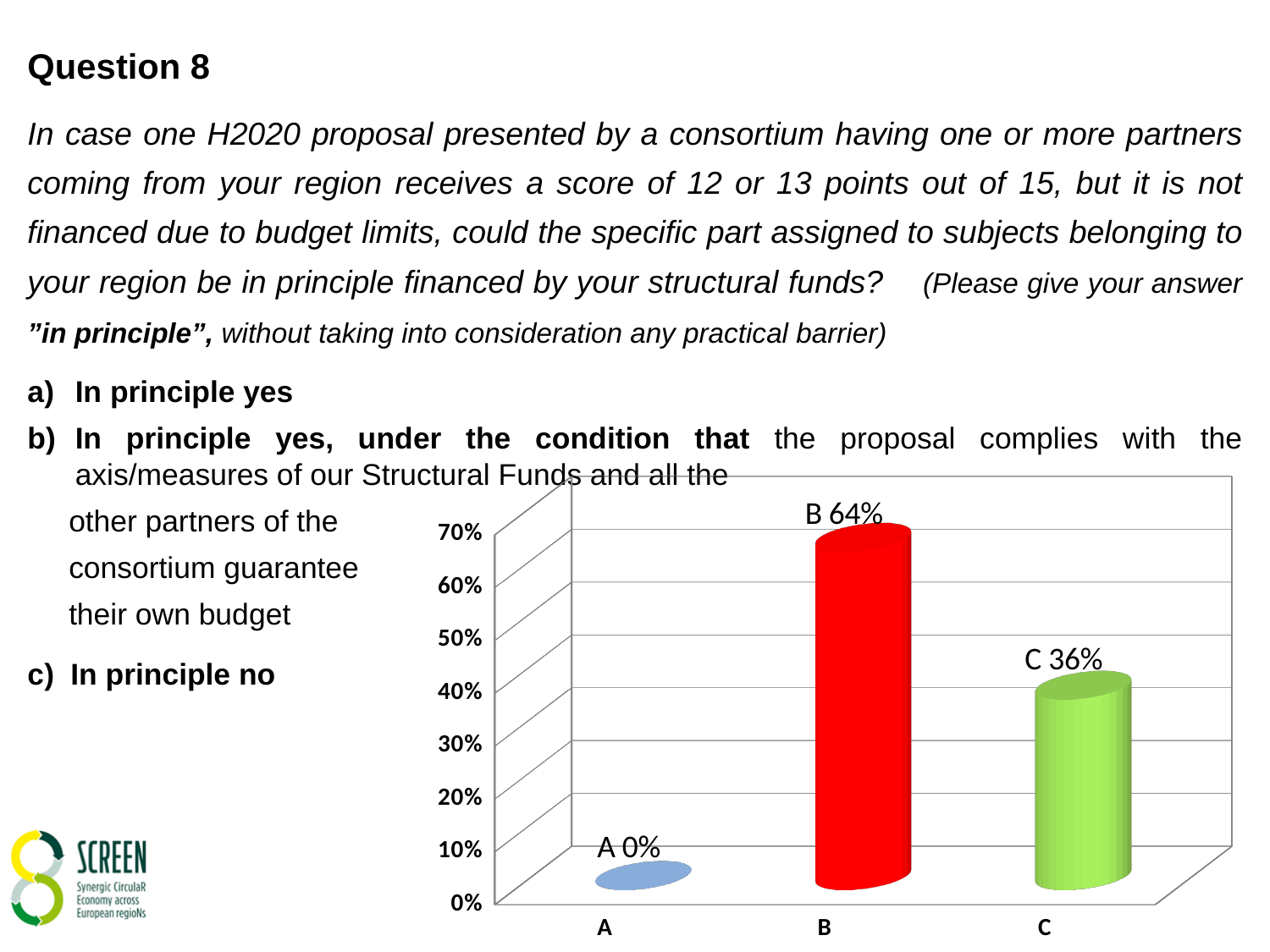
Which category has the lowest value? A What is the highest value shown on the y axis? 70% How many categories are shown on the x axis? 3 Which is larger, the value for B or the value for C? B What kind of chart is shown on the slide? bar chart What is the value for category B? 64% Which category has the highest value? B What colour is the bar for category B? red What is the difference between the values for B and C? 28% Is the value for C greater or less than 40%? less What is the value for category C? 36% What is the value for category A? 0%